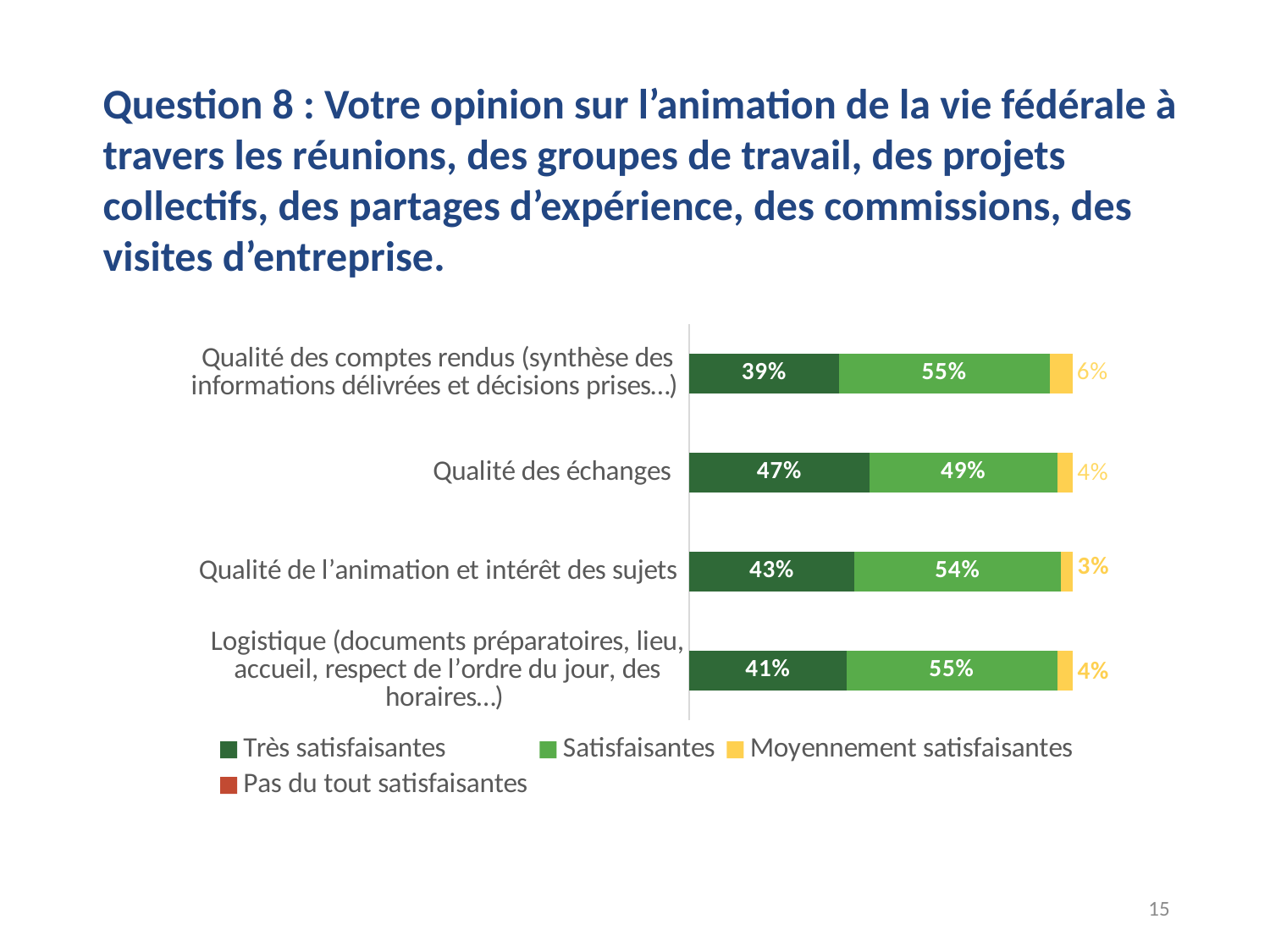
Which legend entry is shown in yellow? Moyennement satisfaisantes How many series does the legend list? 4 What is the 'Très satisfaisantes' value for 'Logistique (documents préparatoires, lieu, accueil, respect de l'ordre du jour, des horaires…)'? 41% What is the 'Moyennement satisfaisantes' value for 'Qualité des comptes rendus (synthèse des informations délivrées et décisions prises…)'? 6% What is the difference between the 'Satisfaisantes' and 'Très satisfaisantes' values for 'Qualité des comptes rendus (synthèse des informations délivrées et décisions prises…)'? 16% Which category has the lowest 'Moyennement satisfaisantes' value? Qualité de l'animation et intérêt des sujets What kind of chart is shown on the slide? Stacked bar chart What is the 'Satisfaisantes' value for 'Qualité de l'animation et intérêt des sujets'? 54% What is the 'Très satisfaisantes' value for 'Qualité des échanges'? 47% How many categories are plotted on the chart? 4 Which category has the highest 'Très satisfaisantes' value? Qualité des échanges Which is larger for 'Qualité des échanges': the 'Très satisfaisantes' value or the 'Satisfaisantes' value? Satisfaisantes